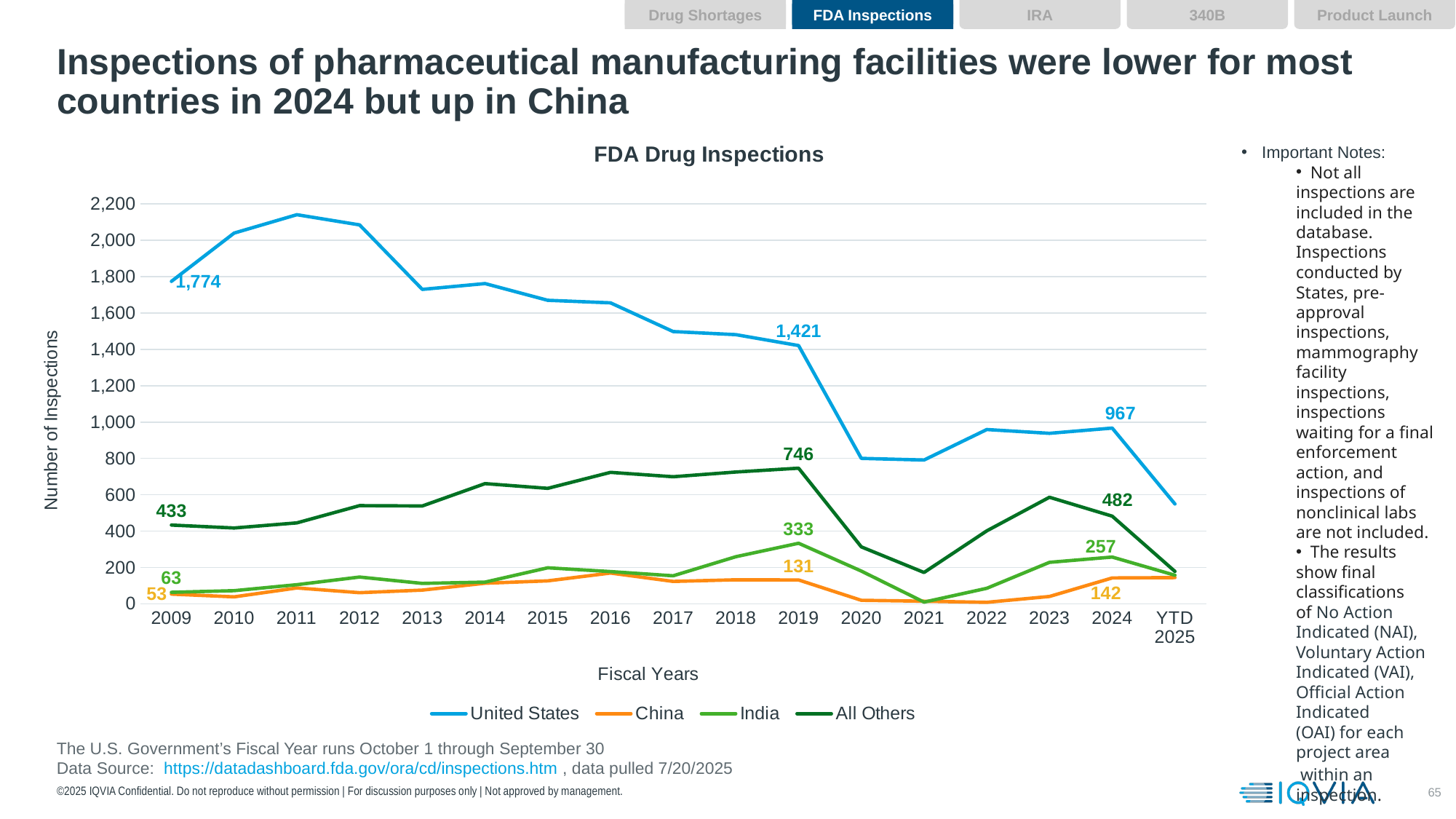
What was the number of inspections for All Others in 2019? 746 Which series had the highest number of inspections in 2009? United States What kind of chart is shown? Line chart Which had more inspections in 2024, India or China? India What is the label on the y axis? Number of Inspections What was the number of FDA drug inspections for the United States in 2009? 1,774 What was the number of inspections for India in 2019? 333 What was the number of inspections for China in 2024? 142 How many series does the legend list? 4 Is the value for the United States in 2011 greater or less than 2,000? greater How many fiscal year points are plotted along the x axis? 17 By how much did United States inspections fall from 2019 to 2024? 454